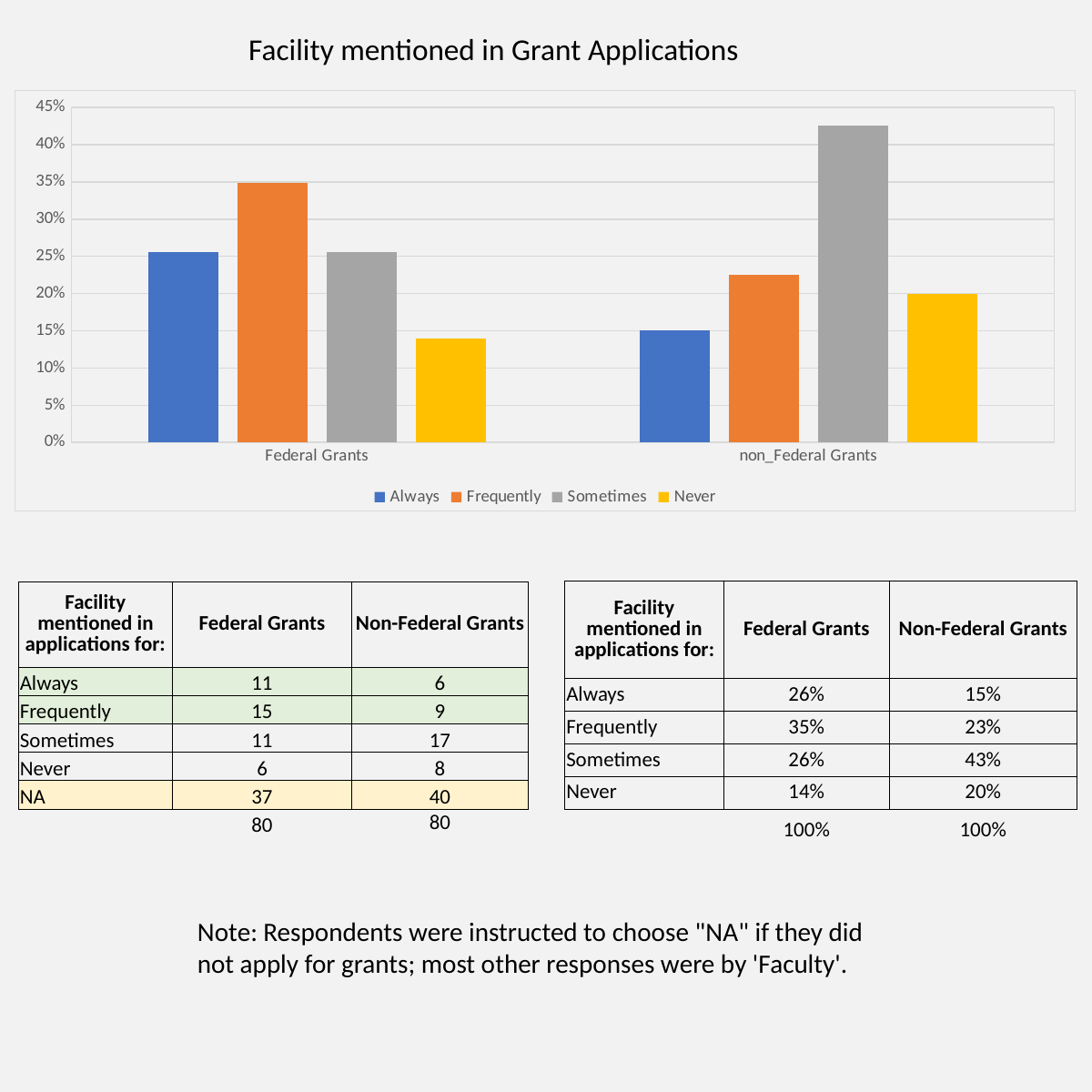
Is the Sometimes value for non_Federal Grants greater or less than 40%? greater Which series has the highest value for Federal Grants? Frequently Which series has the highest value for non_Federal Grants? Sometimes Is the Frequently value for Federal Grants greater or less than 30%? greater What is the title of the chart? Facility mentioned in Grant Applications Is the Always value larger for Federal Grants or for non_Federal Grants? Federal Grants How many categories are shown on the x axis of the chart? 2 What kind of chart is shown on the slide? bar chart Is the Sometimes value larger for Federal Grants or for non_Federal Grants? non_Federal Grants Which series has the lowest value for non_Federal Grants? Always How many series does the chart legend list? 4 Which series has the lowest value for Federal Grants? Never